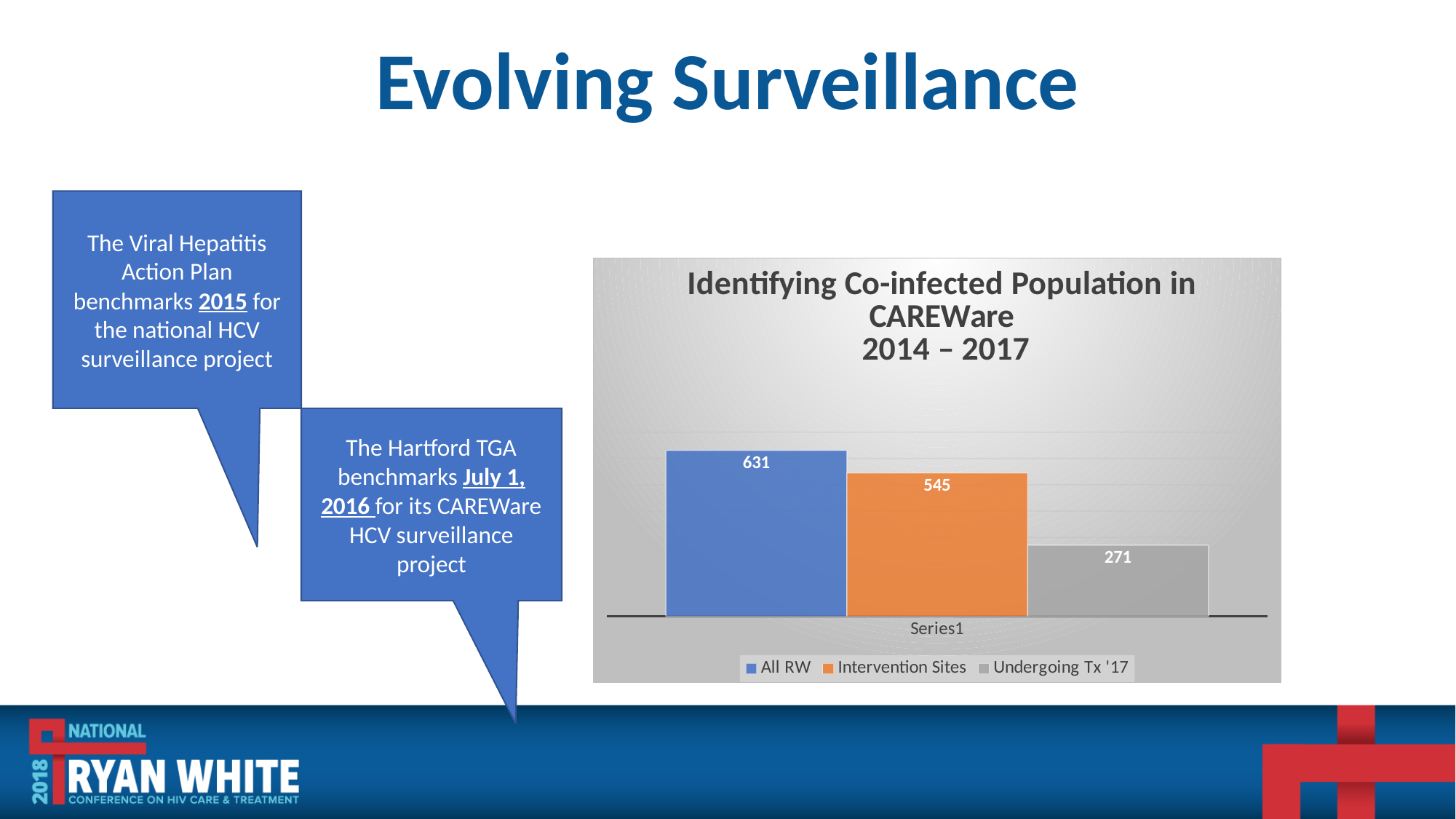
Which is larger, the value for Intervention Sites or the value for Undergoing Tx '17? Intervention Sites What colour is the bar for Intervention Sites? Orange What is the difference between the Intervention Sites value and the Undergoing Tx '17 value? 274 How many series does the legend list? 3 What is the value for Undergoing Tx '17? 271 Which series has the highest value? All RW What is the difference between the All RW value and the Intervention Sites value? 86 What is the value for All RW? 631 What is the title of the chart? Identifying Co-infected Population in CAREWare 2014 – 2017 Which series has the lowest value? Undergoing Tx '17 What is the value for Intervention Sites? 545 What kind of chart is shown on the slide? Bar chart